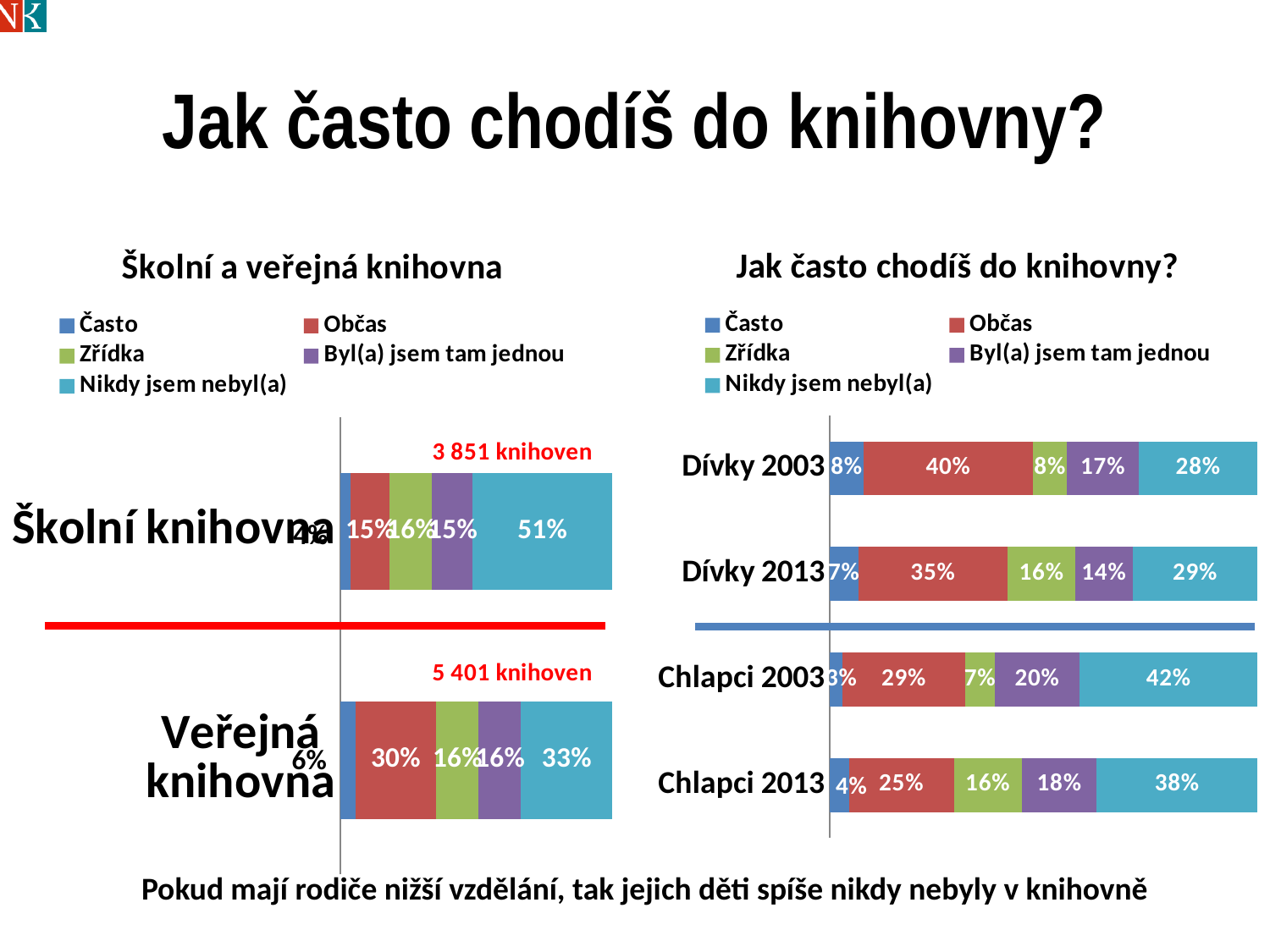
In the chart titled 'Školní a veřejná knihovna', what is the value of 'Občas' for Veřejná knihovna? 30% In the chart titled 'Jak často chodíš do knihovny?', what is the value of 'Byl(a) jsem tam jednou' for Chlapci 2013? 18% In the chart titled 'Jak často chodíš do knihovny?', what is the value of 'Občas' for Dívky 2003? 40% In the chart titled 'Jak často chodíš do knihovny?', how many categories are shown? 4 In the chart titled 'Jak často chodíš do knihovny?', what is the value of 'Zřídka' for Dívky 2013? 16% In the chart titled 'Jak často chodíš do knihovny?', what is the difference between the 'Občas' values for Dívky 2003 and Dívky 2013? 5% In the chart titled 'Školní a veřejná knihovna', how many series does the legend list? 5 In the chart titled 'Školní a veřejná knihovna', what is the value of 'Nikdy jsem nebyl(a)' for Školní knihovna? 51% In the chart titled 'Jak často chodíš do knihovny?', which category has the highest value for 'Nikdy jsem nebyl(a)'? Chlapci 2003 In the chart titled 'Jak často chodíš do knihovny?', what is the value of 'Nikdy jsem nebyl(a)' for Chlapci 2003? 42% In the chart titled 'Jak často chodíš do knihovny?', which is larger: 'Nikdy jsem nebyl(a)' for Dívky 2013 or for Chlapci 2013? Chlapci 2013 What kind of chart is the chart titled 'Školní a veřejná knihovna'? Stacked bar chart